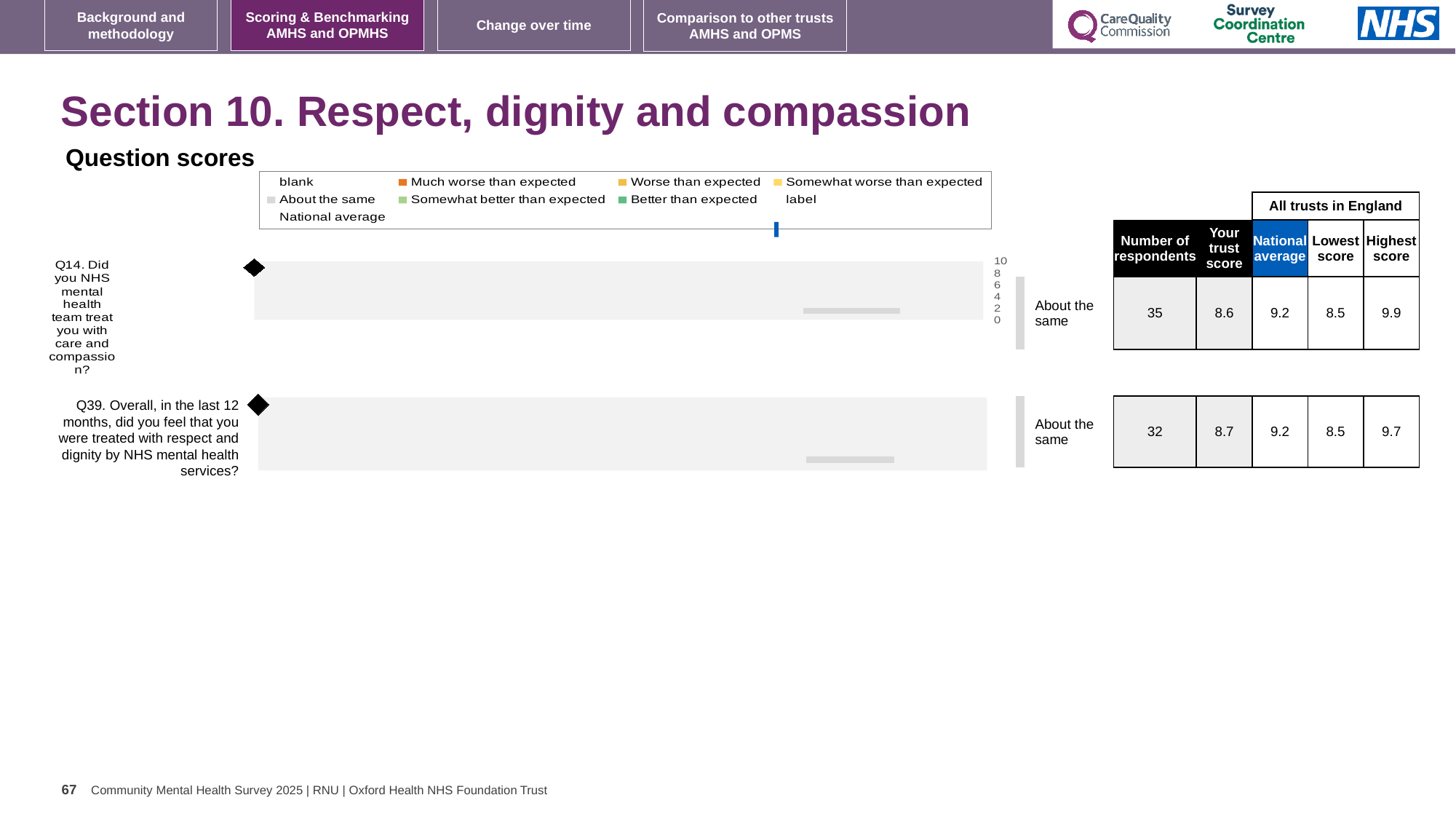
What benchmark category is shown next to the bar for Q14? About the same In the table beside the chart, how many respondents are listed for Q39? 32 What kind of chart is shown under 'Question scores'? bar chart In the table beside the chart, how many respondents are listed for Q14? 35 In the table beside the chart, what is the 'Your trust score' for Q14? 8.6 In the table beside the chart, what is the difference between the national average and the trust score for Q39? 0.5 In the table beside the chart, which question has the higher 'Highest score'? Q14 In the table beside the chart, what is the difference between the highest score and the lowest score for Q14? 1.4 What is the title of the chart on the slide? Question scores How many questions are plotted in the 'Question scores' chart? 2 In the table beside the chart, what is the national average for Q39? 9.2 In the table beside the chart, which question has the higher 'Your trust score', Q14 or Q39? Q39